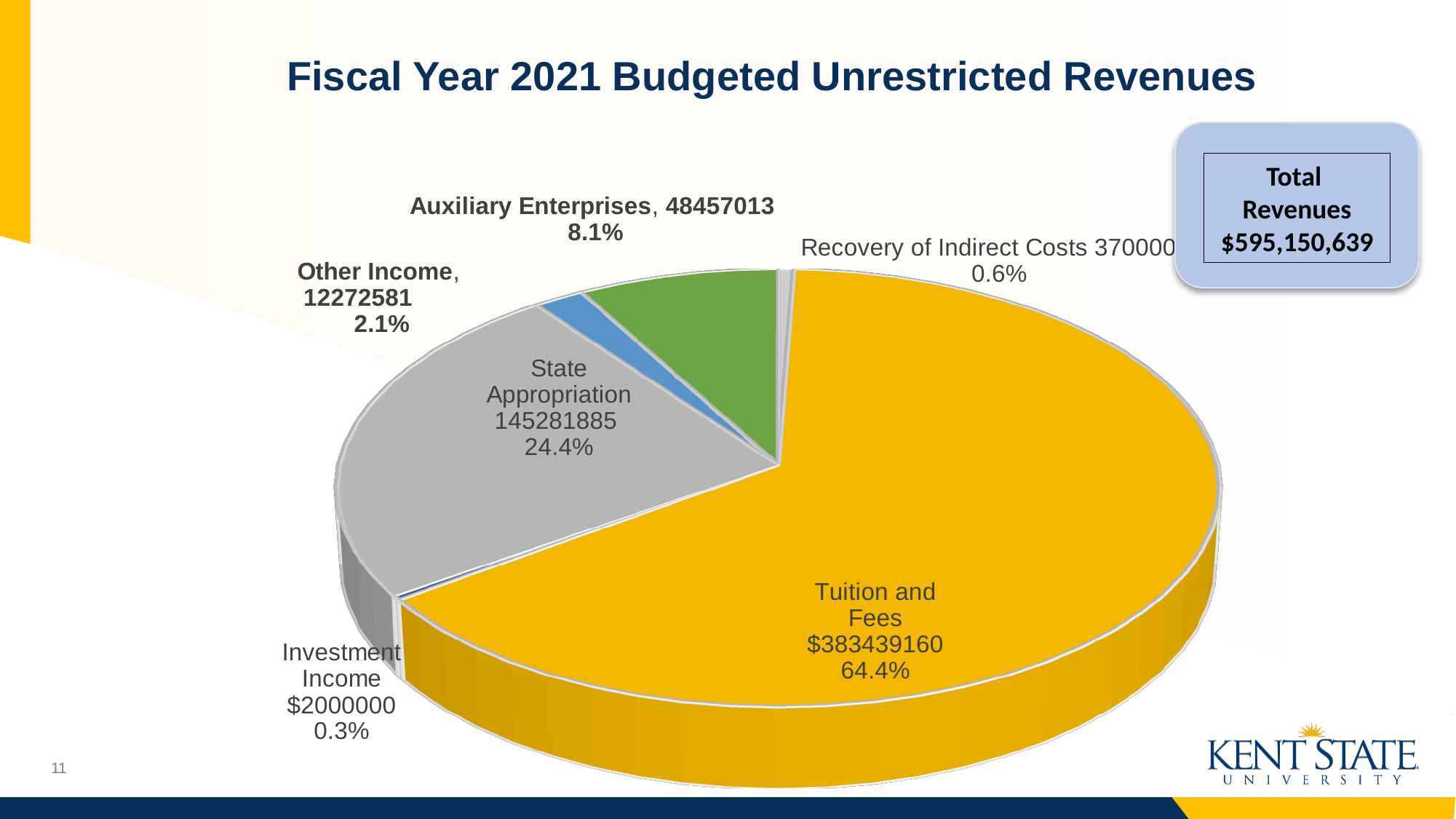
How many revenue categories are shown in the pie chart? 6 What is the value shown for Auxiliary Enterprises? 48457013 What kind of chart is shown on the slide? pie chart What percentage of the pie is Tuition and Fees? 64.4% Which is larger, Auxiliary Enterprises or Other Income? Auxiliary Enterprises What percentage of the pie is Other Income? 2.1% What is the difference between the State Appropriation value and the Auxiliary Enterprises value? 96824872 What is the value shown for State Appropriation? 145281885 Which revenue category has the largest share of the pie? Tuition and Fees What is the value shown for Investment Income? $2000000 What total revenues figure is shown in the box on the slide? $595,150,639 Which revenue category has the smallest share of the pie? Investment Income